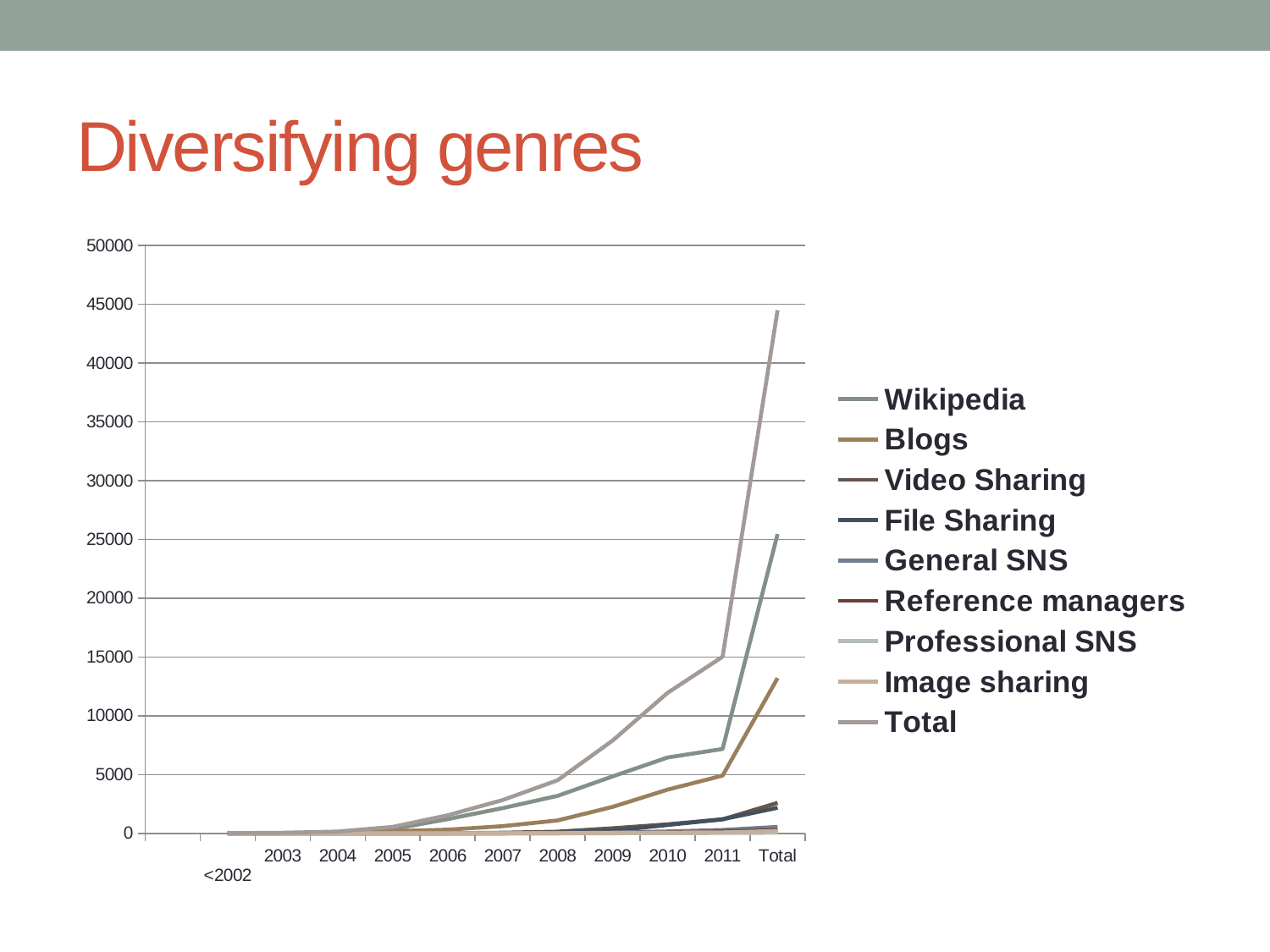
Which is larger at the "Total" category, Wikipedia or Blogs? Wikipedia What kind of chart is shown on the slide? line chart Is the value of the Total series at the "Total" category greater or less than 40000? greater Is the value of the Blogs series at the "Total" category greater or less than 15000? less Is the value of the Wikipedia series at the "Total" category greater or less than 20000? greater Which series reaches the highest value at the "Total" category? Total What is the title of the slide containing the chart? Diversifying genres How many series does the legend list? 9 Excluding the Total series, which series has the highest value at the "Total" category? Wikipedia How many categories are shown along the x axis? 11 Does the Total series rise or fall from <2002 to 2011? rise